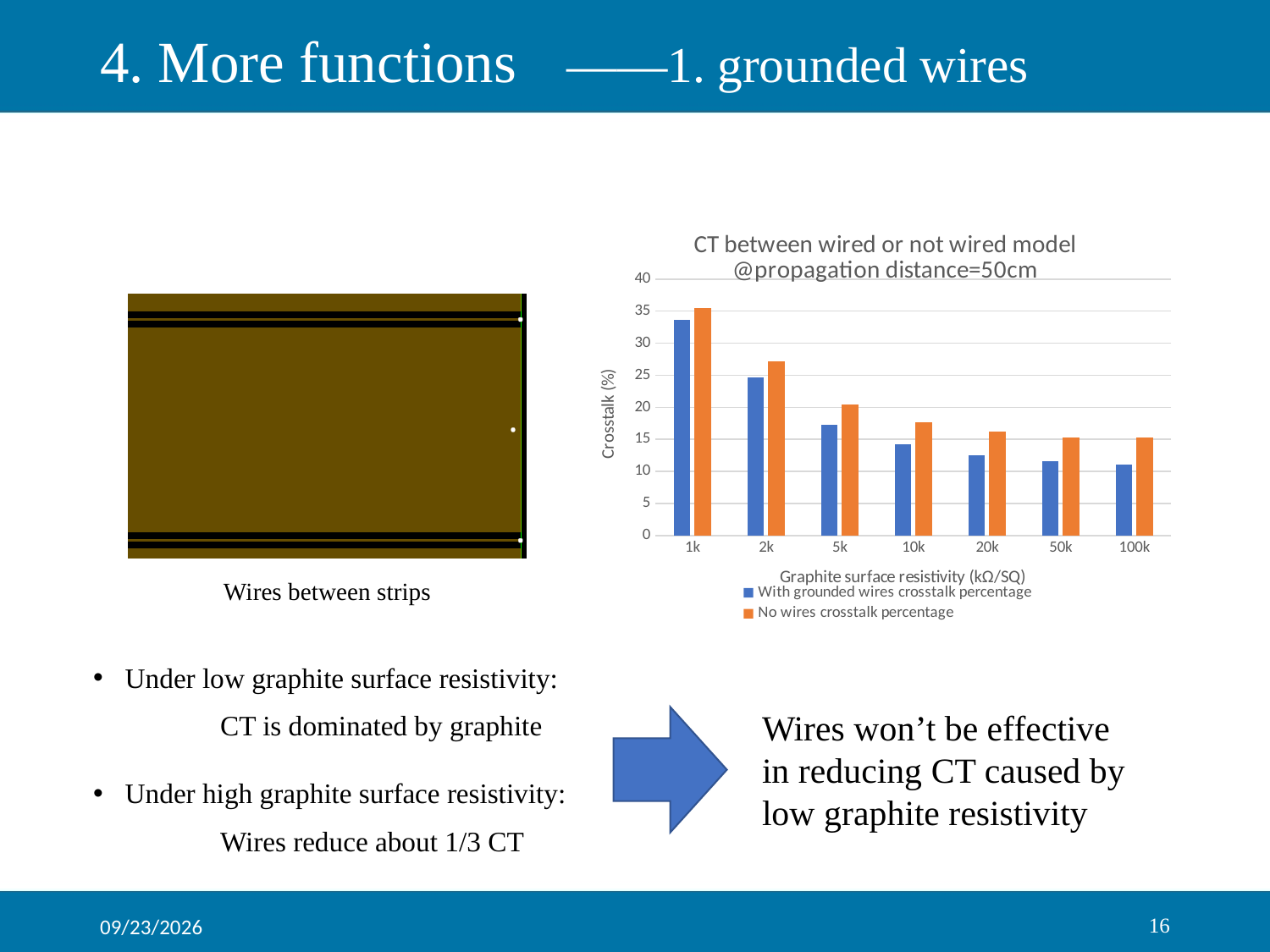
Is the 'With grounded wires crosstalk percentage' value at 20k greater or less than 15? less How many series does the legend list? 2 What kind of chart is shown on the slide? bar chart Is the 'No wires crosstalk percentage' value at 2k greater or less than 25? greater Do the crosstalk values rise or fall as graphite surface resistivity increases along the x axis? fall Which graphite surface resistivity has the highest 'With grounded wires crosstalk percentage'? 1k Which graphite surface resistivity has the highest 'No wires crosstalk percentage'? 1k How many graphite surface resistivity categories are shown on the x axis? 7 Is the 'No wires crosstalk percentage' value at 10k greater or less than 15? greater At 5k, which series has the larger crosstalk value: 'With grounded wires crosstalk percentage' or 'No wires crosstalk percentage'? No wires crosstalk percentage What is the label of the y axis of the chart? Crosstalk (%)